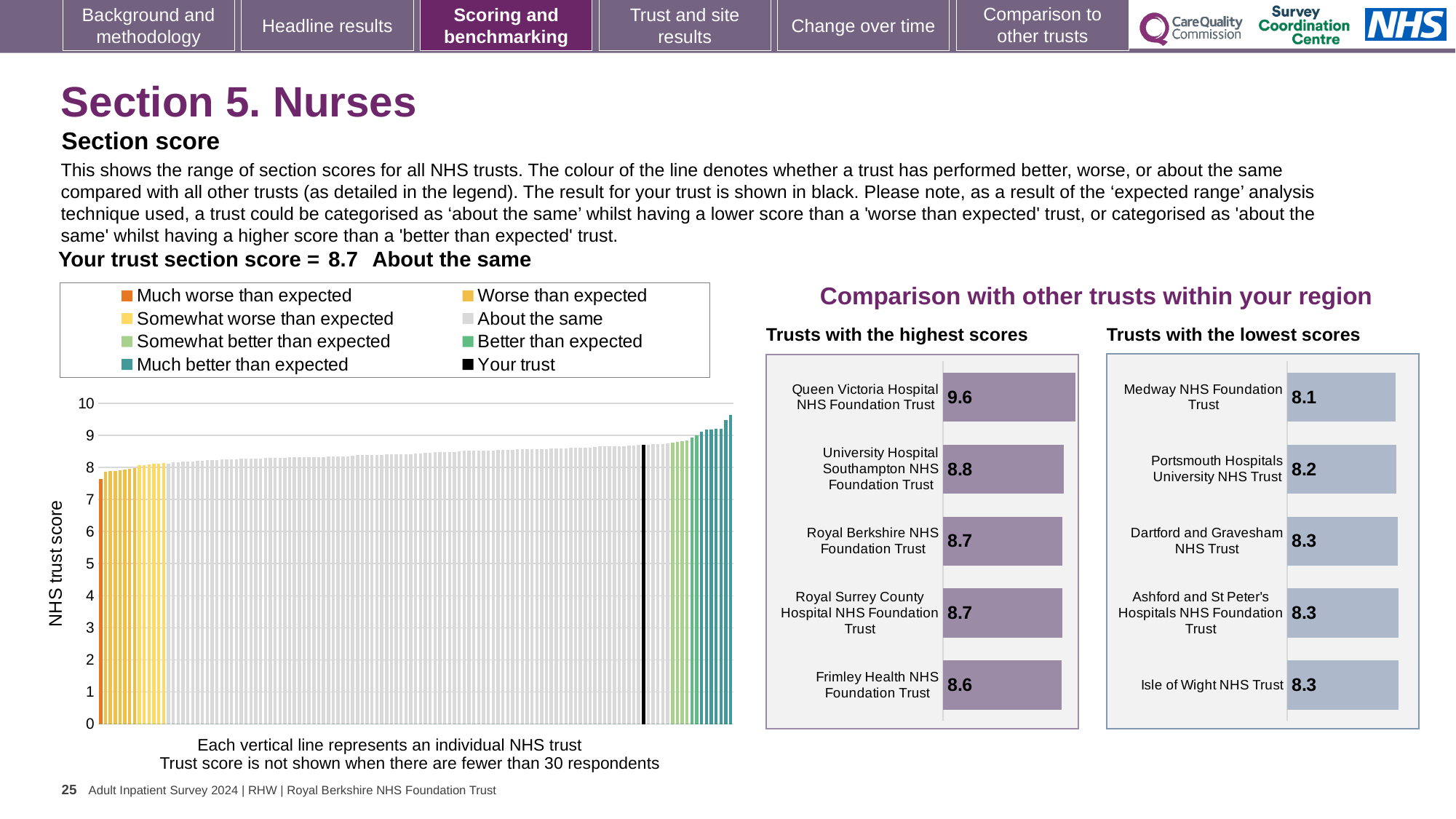
In the 'Trusts with the highest scores' chart, what is the score for Queen Victoria Hospital NHS Foundation Trust? 9.6 How many entries does the legend of the large chart on the left list? 8 In the large chart on the left, do the trust scores rise or fall from left to right along the x axis? rise What kind of chart is the large chart on the left showing NHS trust scores? bar chart In the large chart on the left, is the value of the leftmost (lowest) bar greater or less than 8? less How many trusts are shown in the 'Trusts with the highest scores' chart? 5 In the large chart on the left, what is the section score for your trust (the black bar)? 8.7 In the 'Trusts with the highest scores' chart, which trust has the highest score? Queen Victoria Hospital NHS Foundation Trust In the 'Trusts with the highest scores' chart, what is the difference between the scores of Queen Victoria Hospital NHS Foundation Trust and Frimley Health NHS Foundation Trust? 1.0 In the 'Trusts with the lowest scores' chart, what is the score for Medway NHS Foundation Trust? 8.1 In the 'Trusts with the lowest scores' chart, which trust has the lowest score? Medway NHS Foundation Trust In the 'Trusts with the lowest scores' chart, which has the higher score: Portsmouth Hospitals University NHS Trust or Dartford and Gravesham NHS Trust? Dartford and Gravesham NHS Trust